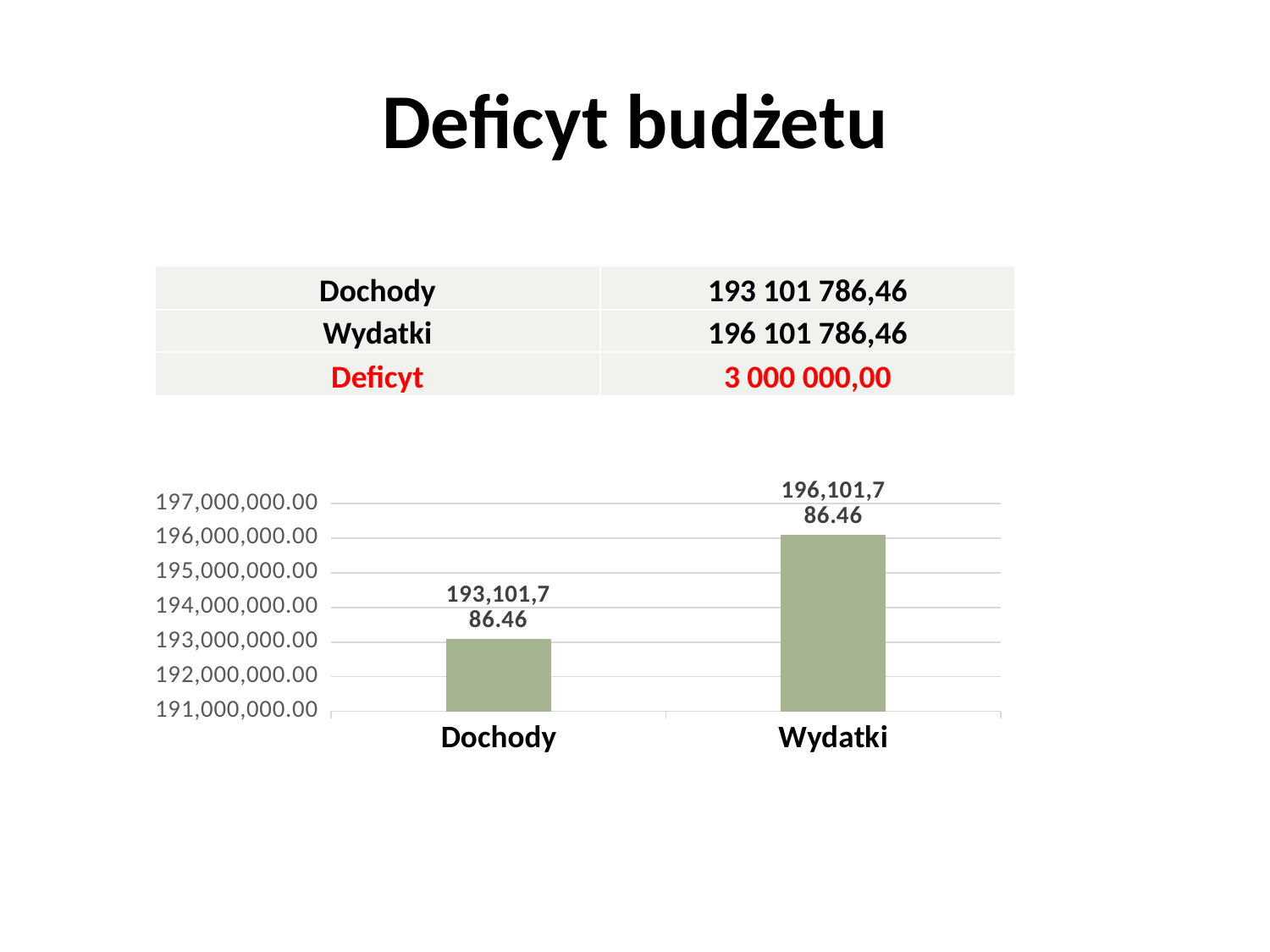
Which category has the highest value in the chart? Wydatki What is the difference between the values for Wydatki and Dochody? 3,000,000.00 What is the value for Dochody in the chart? 193,101,786.46 Is the value for Dochody greater or less than 194,000,000.00? less Do the values rise or fall from Dochody to Wydatki along the x axis? rise What is the value for Wydatki in the chart? 196,101,786.46 Which category has the lowest value in the chart? Dochody Which is larger, the value for Dochody or the value for Wydatki? Wydatki How many categories are shown on the x axis of the chart? 2 What is the title of the slide containing the chart? Deficyt budżetu What kind of chart is shown on the slide? bar chart Is the value for Wydatki greater or less than 195,000,000.00? greater